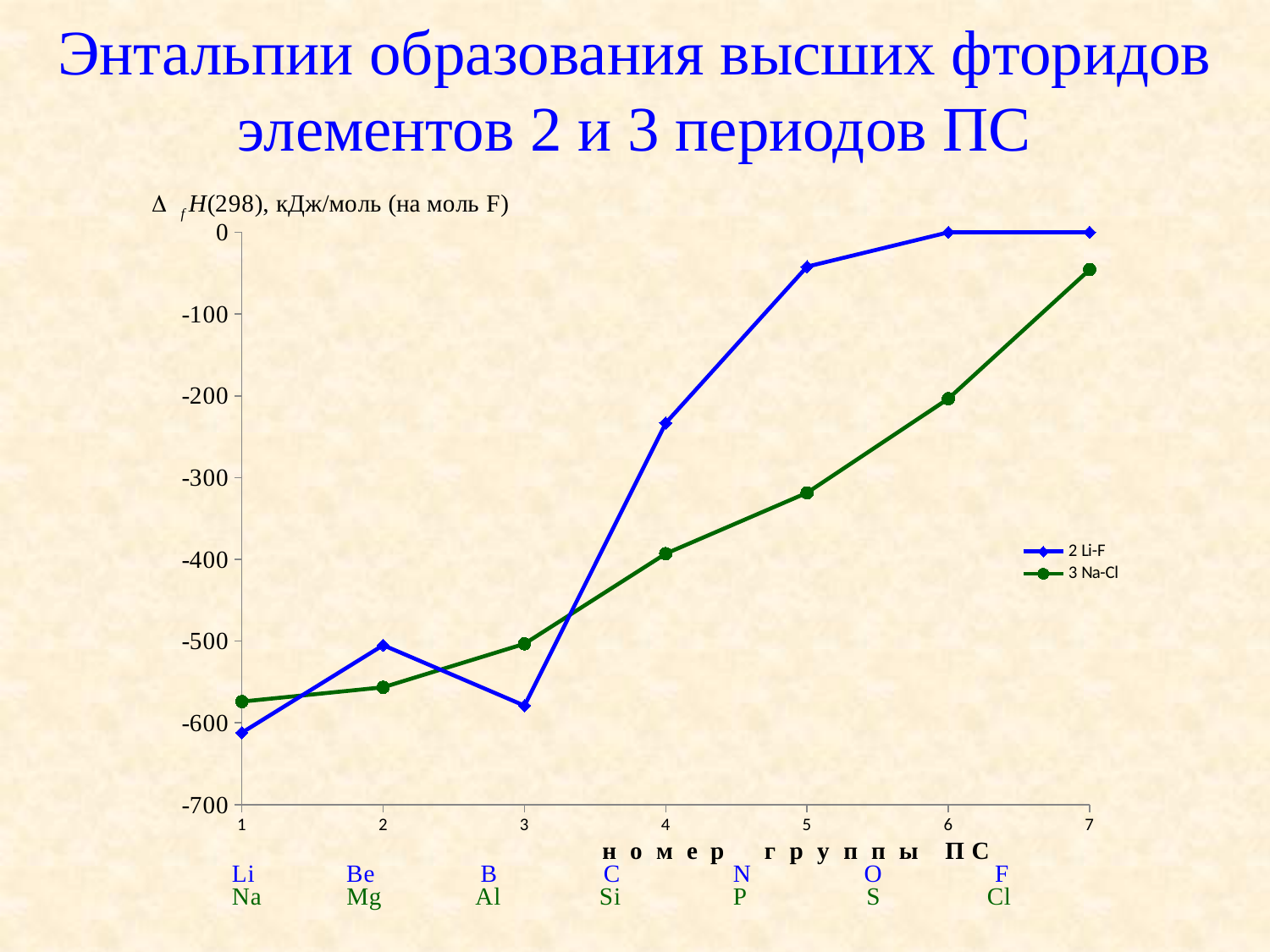
Is the value of the 3 Na-Cl series at group 7 greater or less than -100? greater What kind of chart is shown on the slide? line chart How many group numbers (data points per series) are plotted along the x axis? 7 For the 2 Li-F series, at which group number is the value lowest? 1 How many series does the legend list? 2 At group 4, which series has the higher value, 2 Li-F or 3 Na-Cl? 2 Li-F What are the two series named in the legend? 2 Li-F and 3 Na-Cl Is the value of the 3 Na-Cl series at group 5 greater or less than -300? less Is the value of the 2 Li-F series at group 4 greater or less than -200? less For the 3 Na-Cl series, at which group number is the value lowest? 1 Do the values of the 3 Na-Cl series rise or fall as the group number increases from 1 to 7? rise For the 3 Na-Cl series, at which group number is the value highest? 7